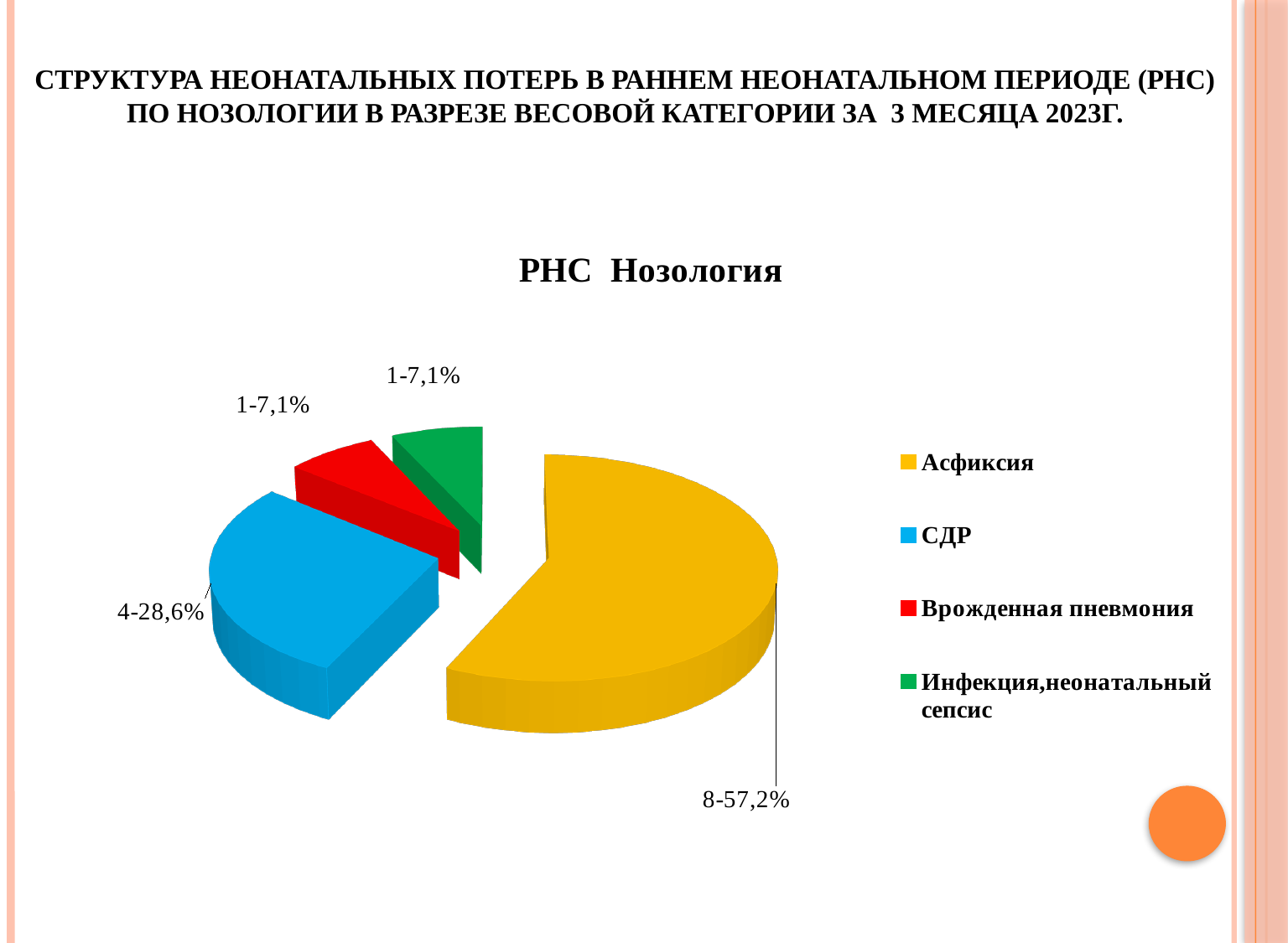
What is the data label shown for the СДР slice? 4-28,6% What percentage share does the Инфекция,неонатальный сепсис slice have? 7,1% What is the title of the chart? РНС Нозология How many categories does the legend of the chart list? 4 What is the data label shown for the Врожденная пневмония slice? 1-7,1% What kind of chart is shown on the slide? pie chart Which category is larger, СДР or Врожденная пневмония? СДР What is the difference in percentage share between Асфиксия and СДР? 28,6% Which category has the largest slice of the pie? Асфиксия What colour is the СДР slice in the chart? blue What is the data label shown for the Асфиксия slice? 8-57,2% How many cases does the Асфиксия slice represent? 8